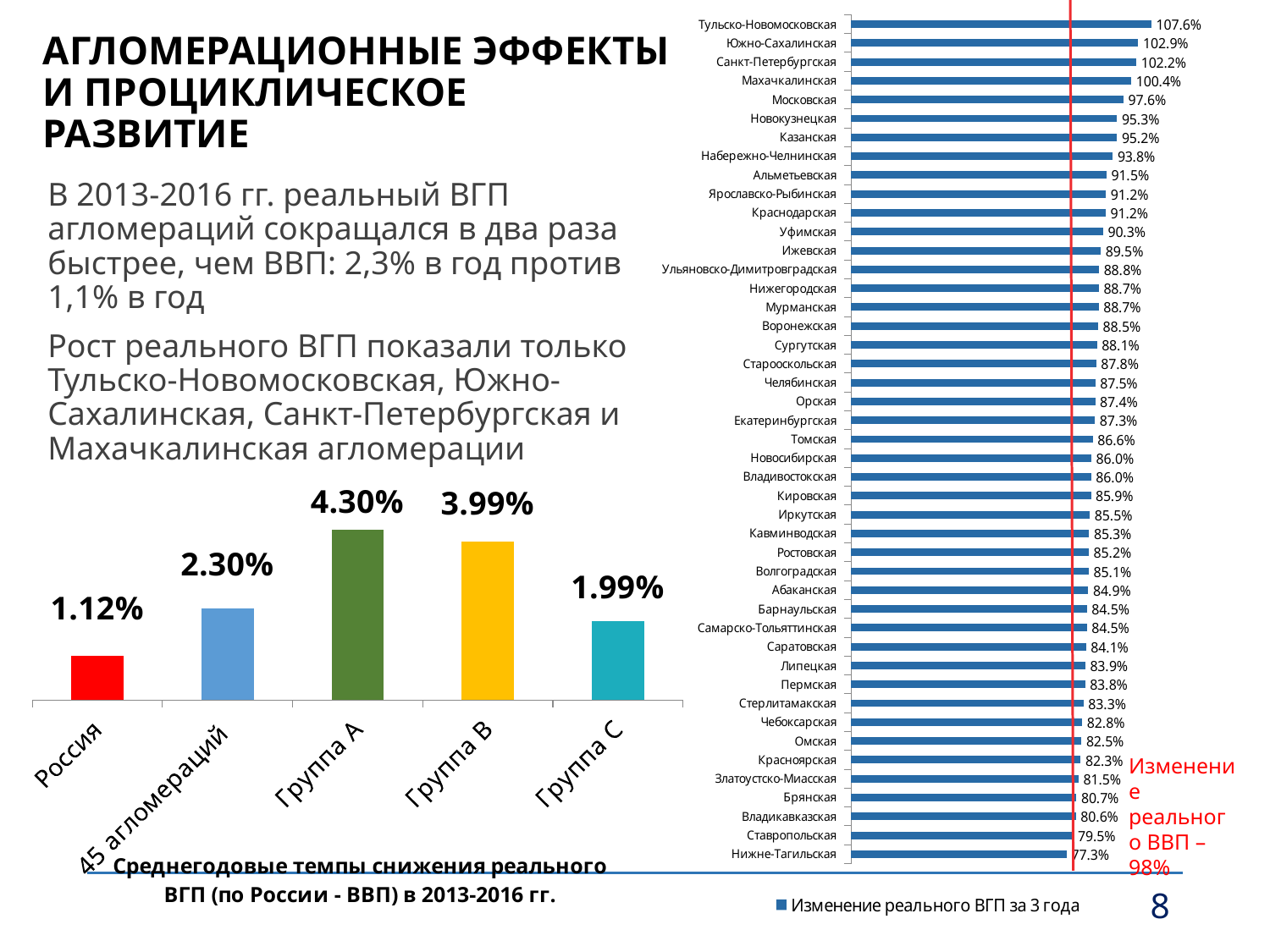
In the right chart (Изменение реального ВГП за 3 года), what is the value for Нижне-Тагильская? 77.3% In the left chart (Среднегодовые темпы снижения реального ВГП), what is the value for Россия? 1.12% What type of chart is the right chart (Изменение реального ВГП за 3 года)? Bar chart In the left chart (Среднегодовые темпы снижения реального ВГП), what is the difference between Группа A and Группа B? 0.31% In the right chart (Изменение реального ВГП за 3 года), what is the value for Московская? 97.6% In the left chart (Среднегодовые темпы снижения реального ВГП), what is the value for Группа A? 4.30% In the left chart (Среднегодовые темпы снижения реального ВГП), which category has the highest value? Группа A In the right chart (Изменение реального ВГП за 3 года), which is larger: Казанская or Уфимская? Казанская In the left chart (Среднегодовые темпы снижения реального ВГП), how many categories are shown? 5 In the left chart (Среднегодовые темпы снижения реального ВГП), which category has the lowest value? Россия In the right chart (Изменение реального ВГП за 3 года), which agglomeration has the highest value? Тульско-Новомосковская In the right chart (Изменение реального ВГП за 3 года), what is the difference between Тульско-Новомосковская and Южно-Сахалинская? 4.7%